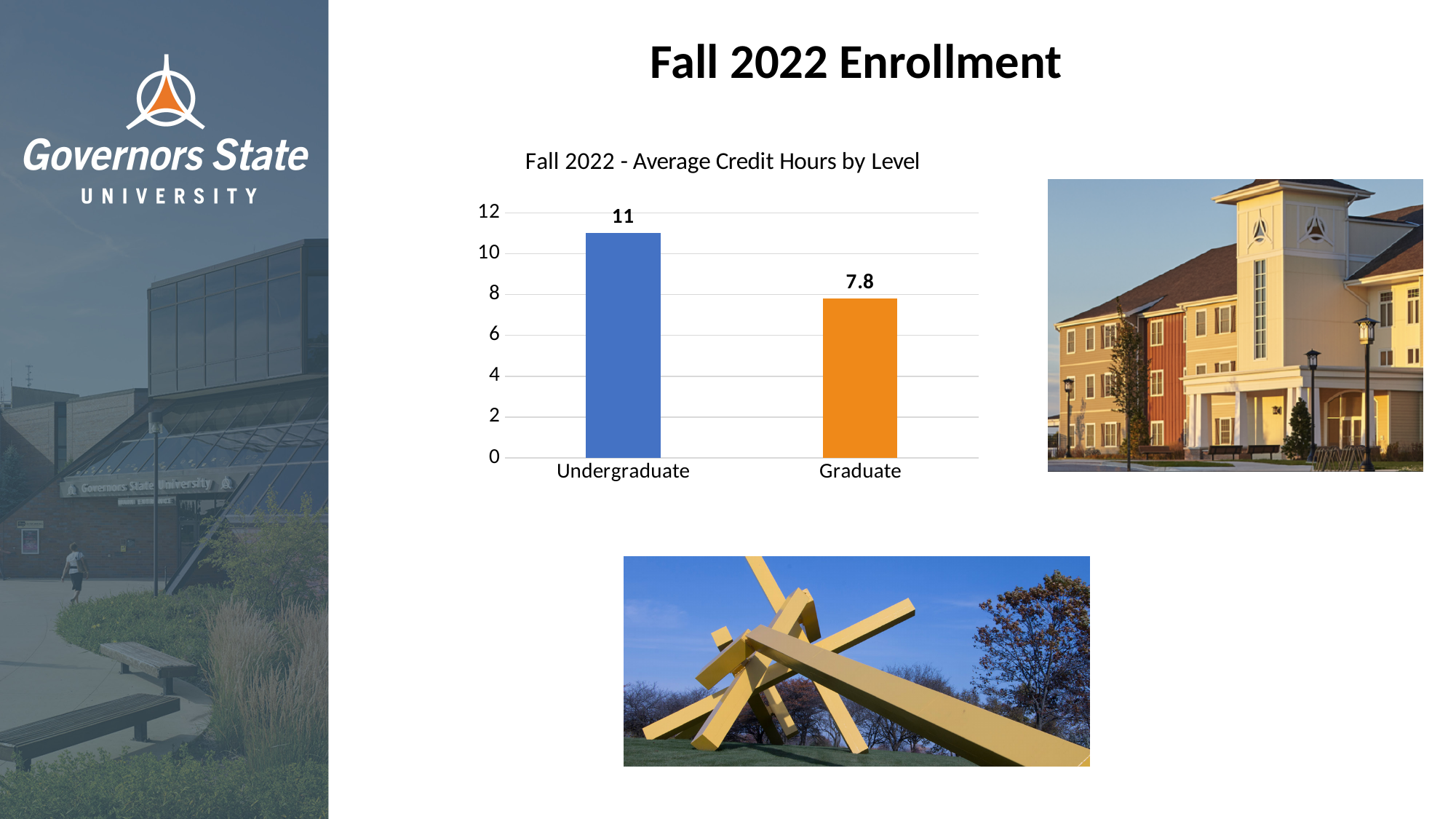
What is the title of the chart? Fall 2022 - Average Credit Hours by Level What kind of chart is shown on the slide? Bar chart Which level has the lowest average credit hours? Graduate What is the difference in average credit hours between Undergraduate and Graduate? 3.2 Is the value for Undergraduate greater or less than 10? greater Which level has the highest average credit hours? Undergraduate How many categories are shown in the chart? 2 Which is larger, the average credit hours for Undergraduate or for Graduate? Undergraduate What colour is the Graduate bar? Orange What is the average credit hours value for Graduate? 7.8 Is the value for Graduate greater or less than 8? less What is the average credit hours value for Undergraduate? 11